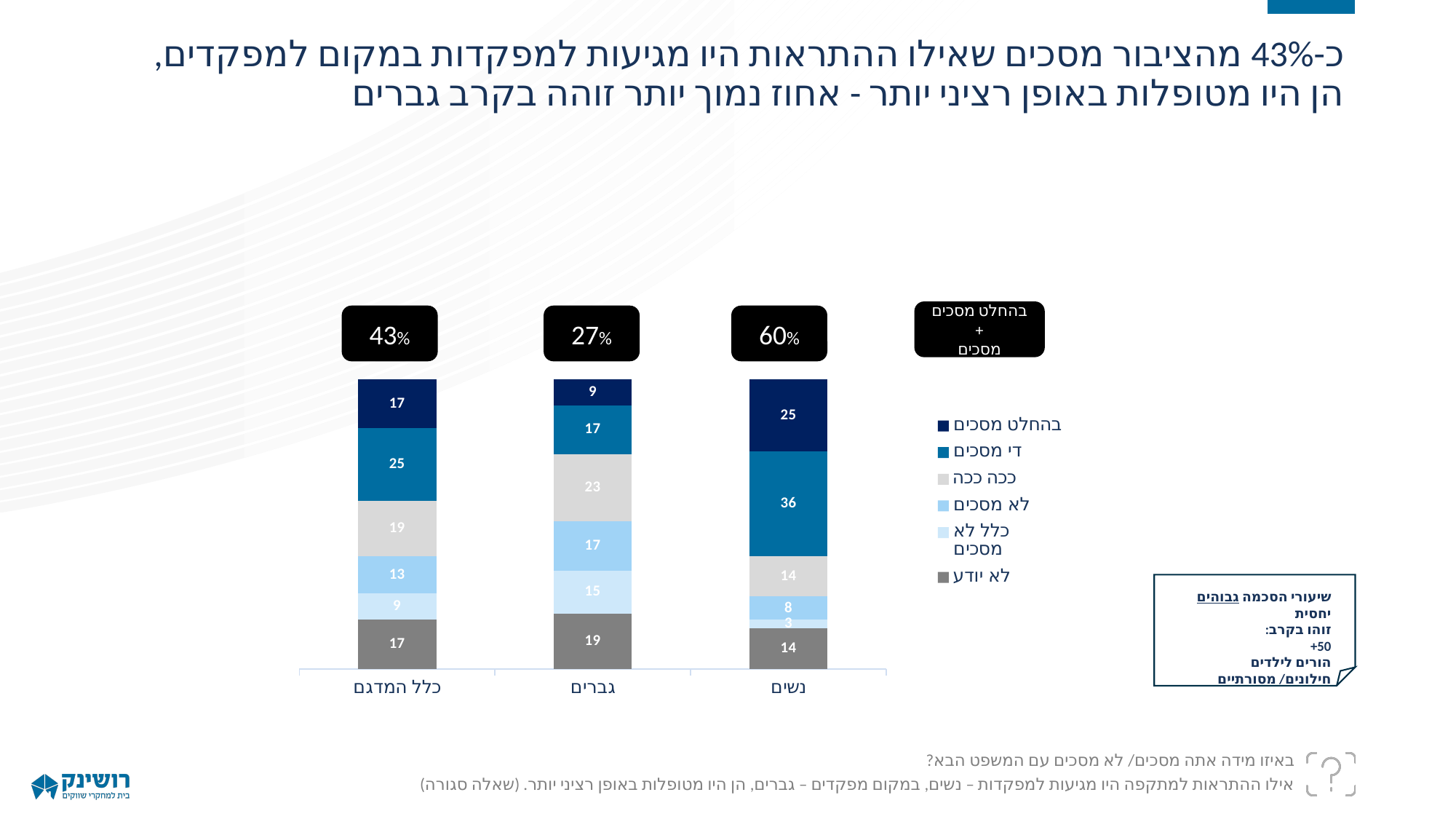
What is the value of the 'לא יודע' segment for 'כלל המדגם'? 17 What type of chart is shown on the slide? stacked bar chart What is the value of the 'בהחלט מסכים' segment for 'נשים'? 25 What is the value of the 'די מסכים' segment for 'גברים'? 17 Which category has the highest combined percentage shown above its bar? נשים Which is larger: the 'ככה ככה' value for 'גברים' or for 'נשים'? גברים What is the difference between the 'די מסכים' values for 'נשים' and 'גברים'? 19 What combined percentage (בהחלט מסכים + מסכים) is shown above the 'גברים' bar? 27% How many series does the chart legend list? 6 What is the total of all segments in the 'נשים' bar? 100 How many categories are shown along the x axis of the chart? 3 Which category has the lowest combined percentage shown above its bar? גברים